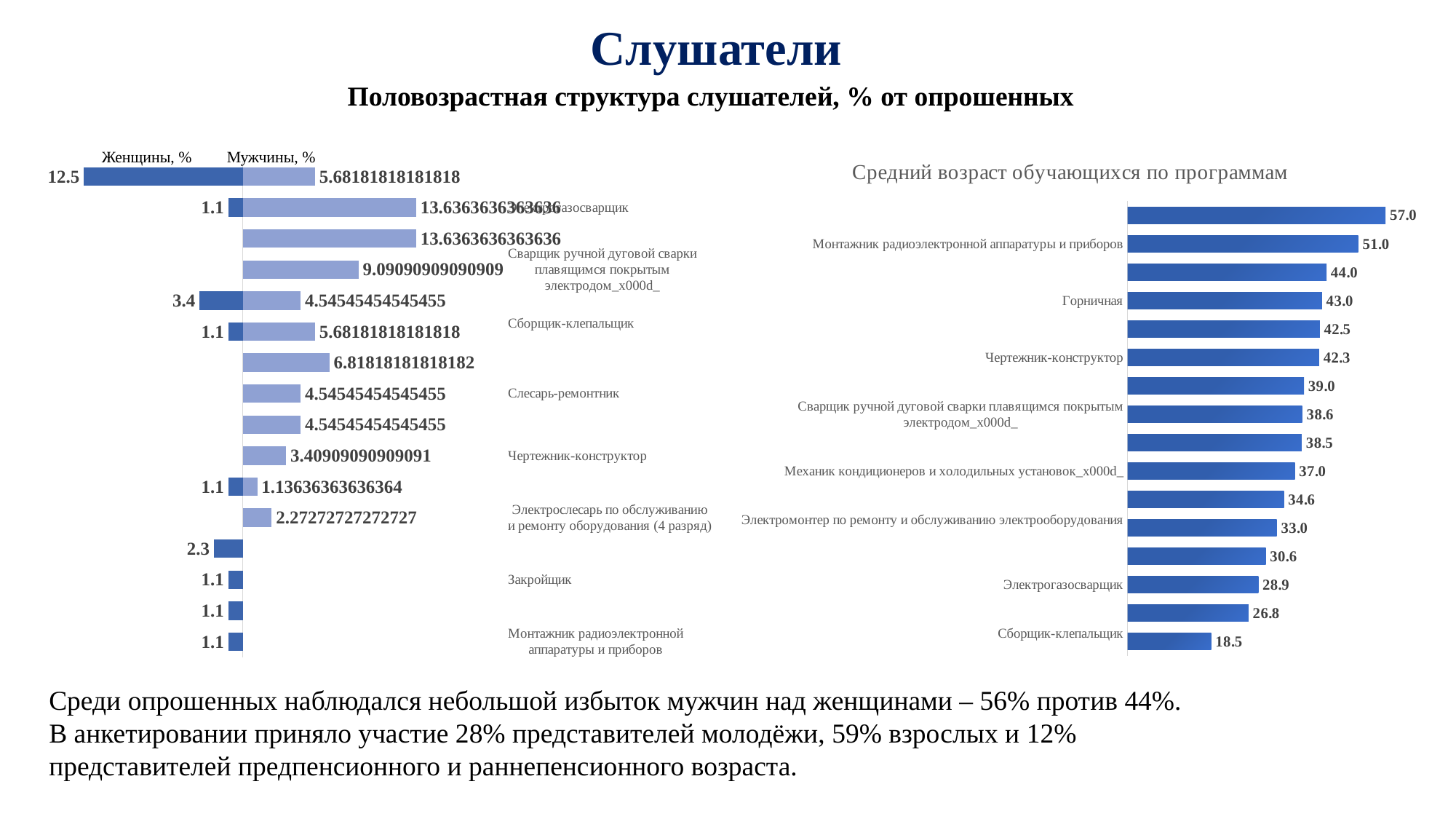
On the chart titled "Средний возраст обучающихся по программам", what is the value for Электрогазосварщик? 28.9 On the chart titled "Средний возраст обучающихся по программам", which is larger: the value for Чертежник-конструктор or the value for Механик кондиционеров и холодильных установок? Чертежник-конструктор On the chart titled "Средний возраст обучающихся по программам", what is the value for Горничная? 43.0 What kind of chart is the chart titled "Средний возраст обучающихся по программам"? bar chart On the chart titled "Средний возраст обучающихся по программам", how many bars are plotted? 16 On the chart titled "Средний возраст обучающихся по программам", what is the value for Сборщик-клепальщик? 18.5 On the left chart (Женщины, % / Мужчины, %), what is the largest value in the Женщины, % series? 12.5 On the chart titled "Средний возраст обучающихся по программам", which labelled program has the lowest average age? Сборщик-клепальщик On the chart titled "Средний возраст обучающихся по программам", what is the highest value shown? 57.0 On the chart titled "Средний возраст обучающихся по программам", what is the difference between the values for Горничная and Электрогазосварщик? 14.1 On the chart titled "Средний возраст обучающихся по программам", what is the value for Монтажник радиоэлектронной аппаратуры и приборов? 51.0 On the left chart (Женщины, % / Мужчины, %), how many series are shown? 2